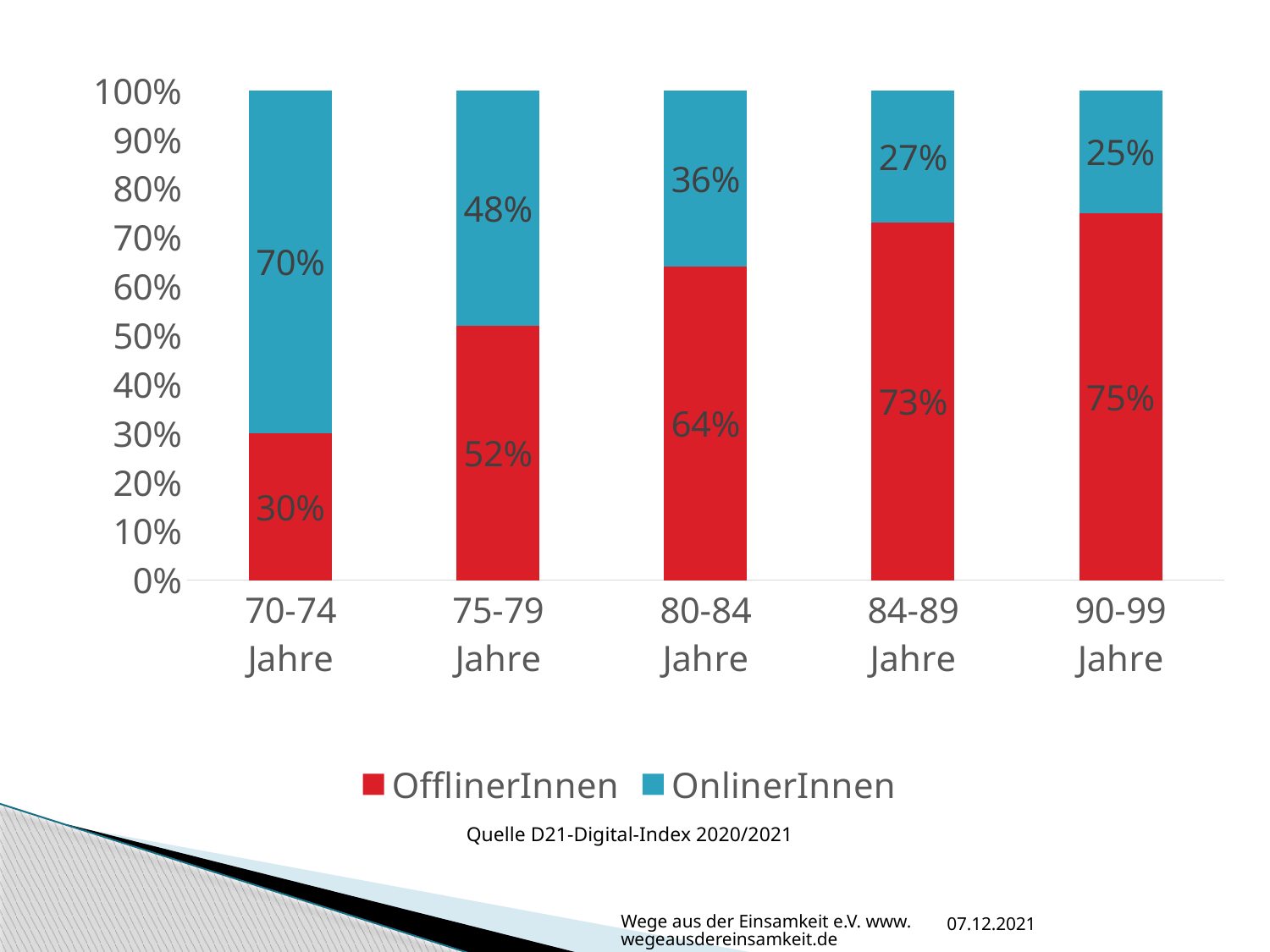
Which age group has the lowest OnlinerInnen share? 90-99 Jahre Which is larger: the OnlinerInnen value for 80-84 Jahre or the OnlinerInnen value for 84-89 Jahre? 80-84 Jahre What kind of chart is shown on the slide? Stacked bar chart Which age group has the highest OfflinerInnen share? 90-99 Jahre How many age groups are shown on the x axis? 5 Does the OfflinerInnen share rise or fall as the age groups increase along the x axis? Rise What is the OfflinerInnen value for 80-84 Jahre? 64% What is the difference between the OfflinerInnen values for 84-89 Jahre and 70-74 Jahre? 43% How many series does the legend list? 2 What is the OnlinerInnen value for 90-99 Jahre? 25% What is the OnlinerInnen value for 75-79 Jahre? 48% What is the OfflinerInnen value for 70-74 Jahre? 30%